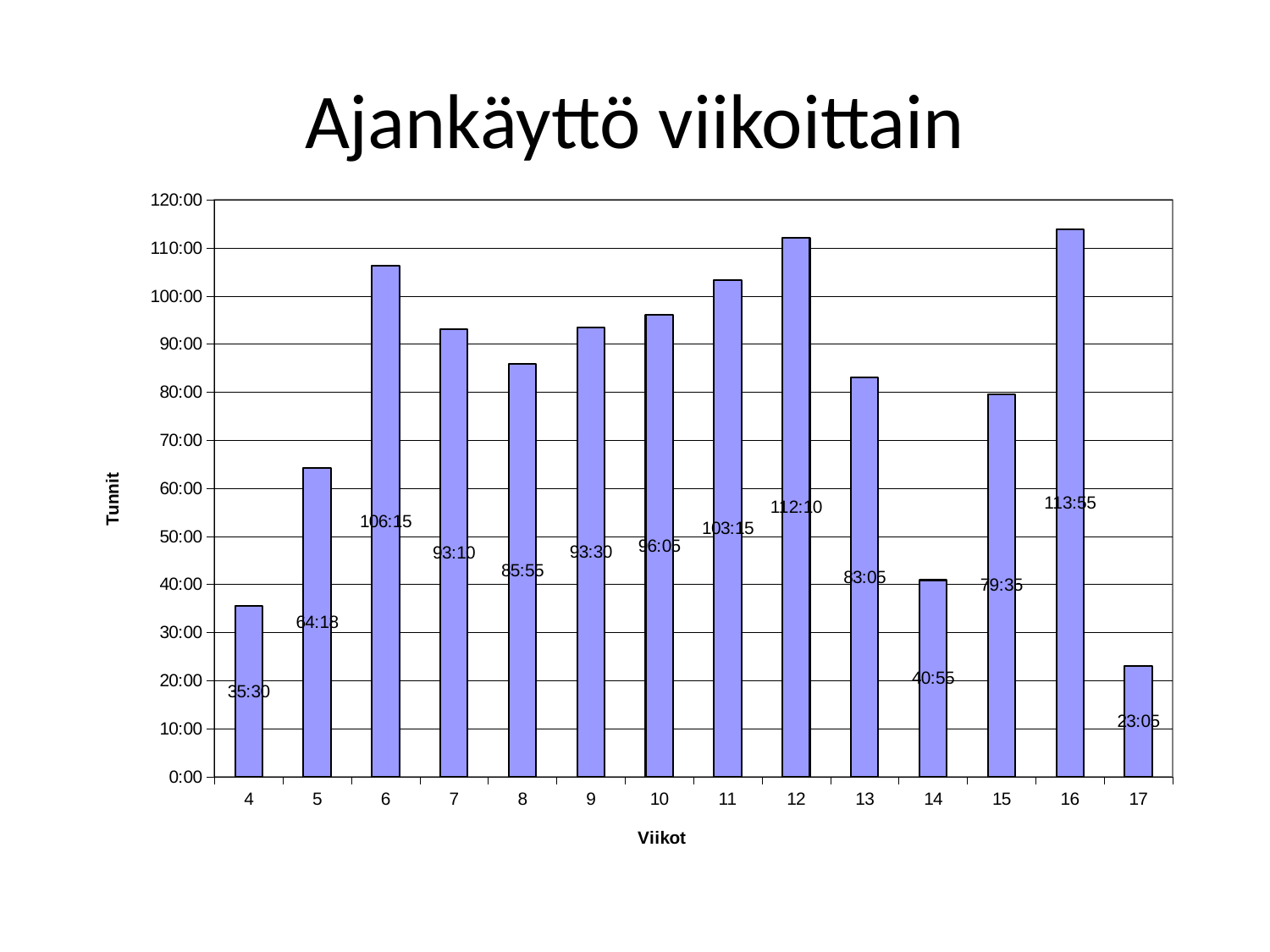
What is the value for week 9? 93:30 How many weeks are shown on the x axis? 14 What is the title of the chart? Ajankäyttö viikoittain Which week has the highest value? 16 What is the value for week 6? 106:15 What is the value for week 14? 40:55 What is the difference between the values for week 12 and week 13? 29:05 Which is larger, the value for week 5 or the value for week 15? week 15 What kind of chart is shown on the slide? bar chart Is the value for week 8 greater or less than 80:00? greater Which week has the lowest value? 17 What is the label of the y axis? Tunnit